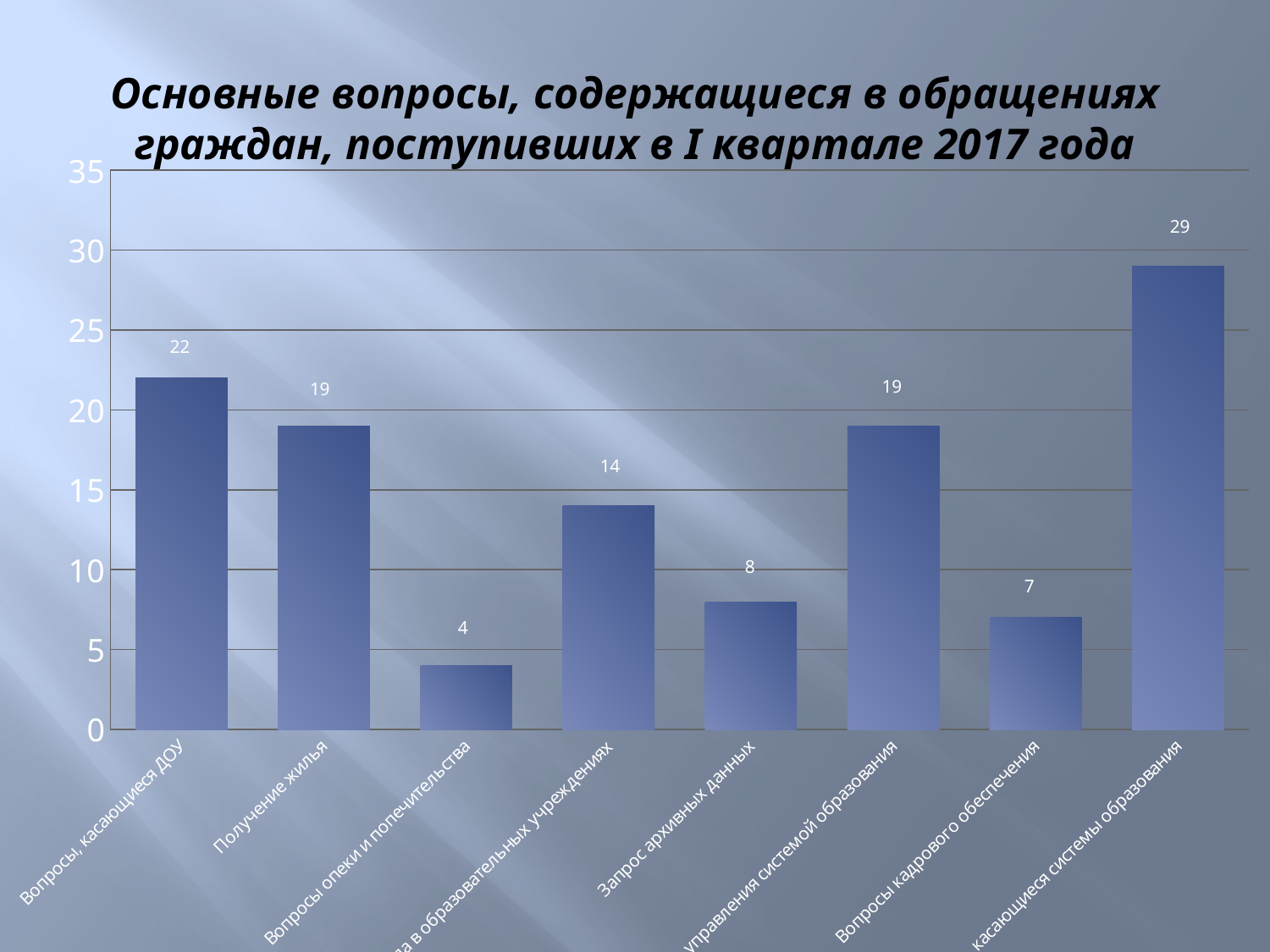
What kind of chart is shown on the slide? Bar chart How many categories are shown in the chart? 8 What is the difference between the values for Вопросы, касающиеся ДОУ and Получение жилья? 3 What is the title of the chart? Основные вопросы, содержащиеся в обращениях граждан, поступивших в I квартале 2017 года What is the value for Вопросы опеки и попечительства? 4 What is the value for Получение жилья? 19 What is the value for Вопросы кадрового обеспечения? 7 What is the value for Вопросы, касающиеся ДОУ? 22 Which category has the lowest value? Вопросы опеки и попечительства What is the value for Запрос архивных данных? 8 What is the value of the tallest bar in the chart? 29 Which is larger, the value for Запрос архивных данных or the value for Вопросы кадрового обеспечения? Запрос архивных данных